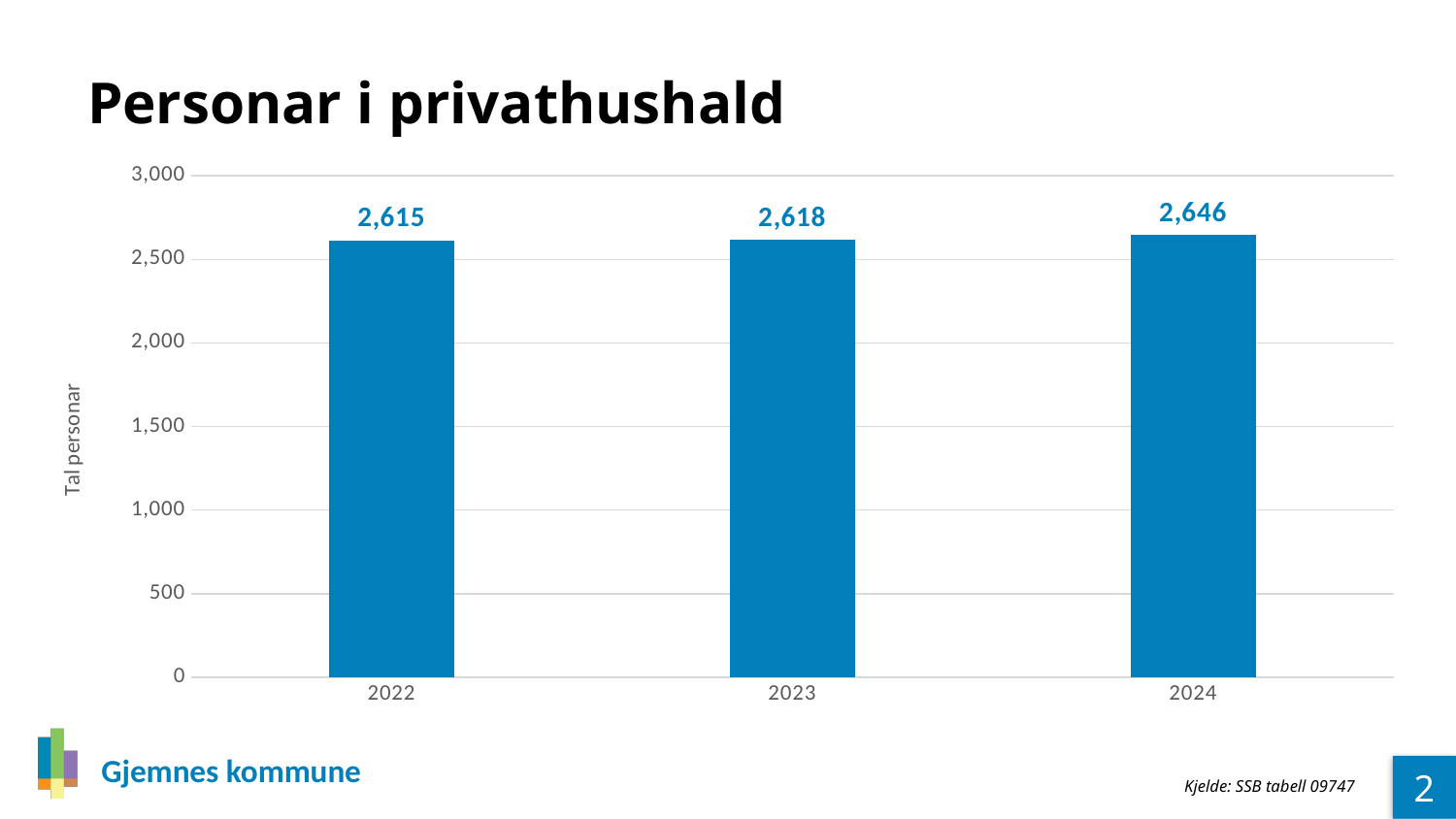
What is the difference between the values for 2024 and 2023? 28 Do the values rise or fall from 2022 to 2024? rise What is the title of the chart? Personar i privathushald Which is larger, the value for 2024 or the value for 2022? 2024 Is the value for 2023 greater or less than 2,500? greater Which year has the highest value? 2024 What kind of chart is shown on the slide? bar chart What is the value for 2022? 2,615 What is the value for 2024? 2,646 How many years are shown on the x axis? 3 What is the difference between the values for 2024 and 2022? 31 What is the value for 2023? 2,618